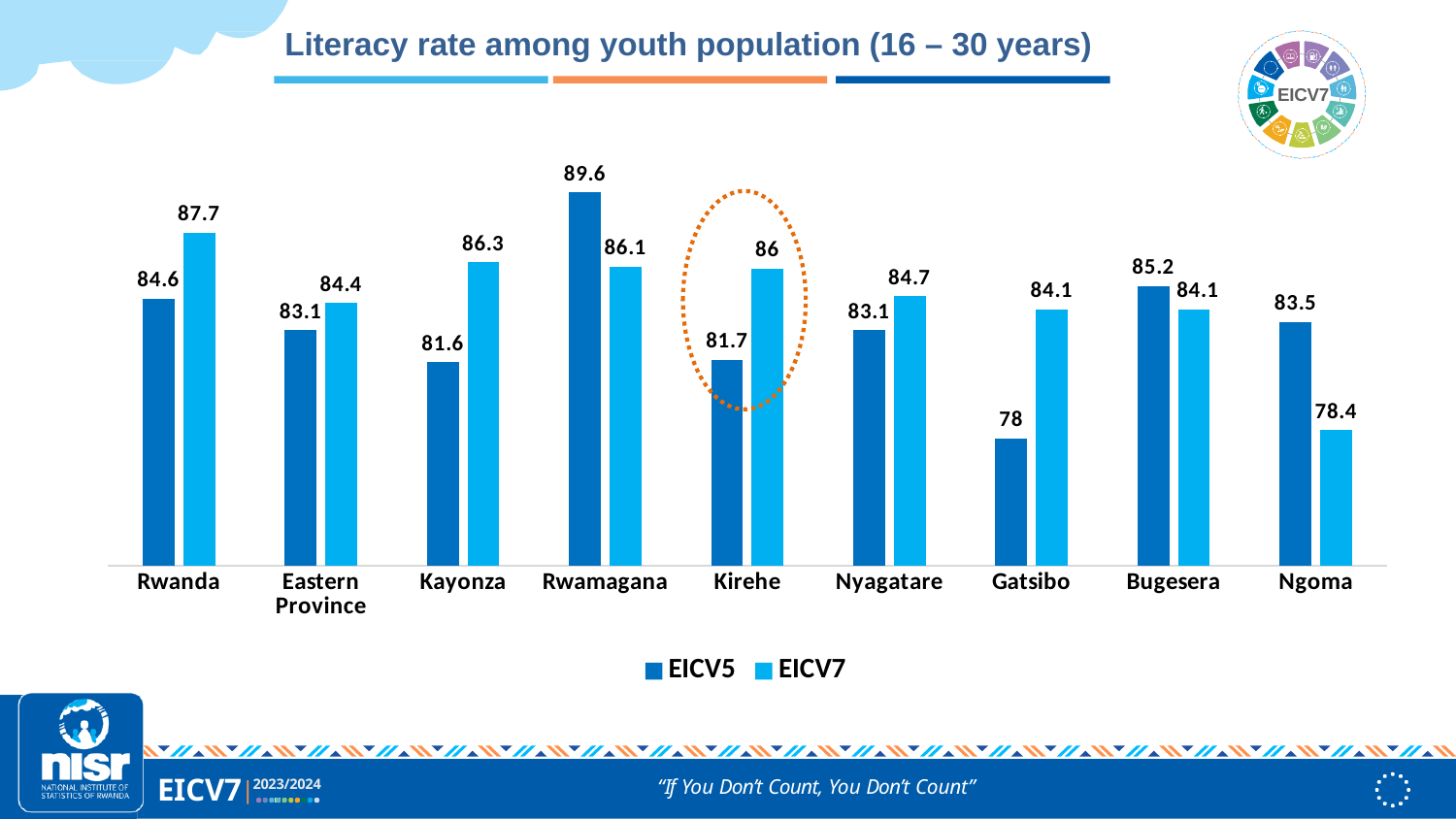
Which is larger for Kayonza, the EICV5 value or the EICV7 value? EICV7 What is the EICV7 literacy rate for Kirehe? 86 How many series does the legend list? 2 Which category has the highest EICV5 value? Rwamagana Which category is highlighted with a dotted orange circle? Kirehe What is the EICV5 literacy rate for Gatsibo? 78 What is the EICV7 literacy rate for Rwanda? 87.7 What is the difference between the EICV7 and EICV5 values for Gatsibo? 6.1 How many categories are shown on the x axis? 9 Which is larger for Ngoma, the EICV5 value or the EICV7 value? EICV5 What kind of chart is shown on the slide? Bar chart Which category has the lowest EICV7 value? Ngoma